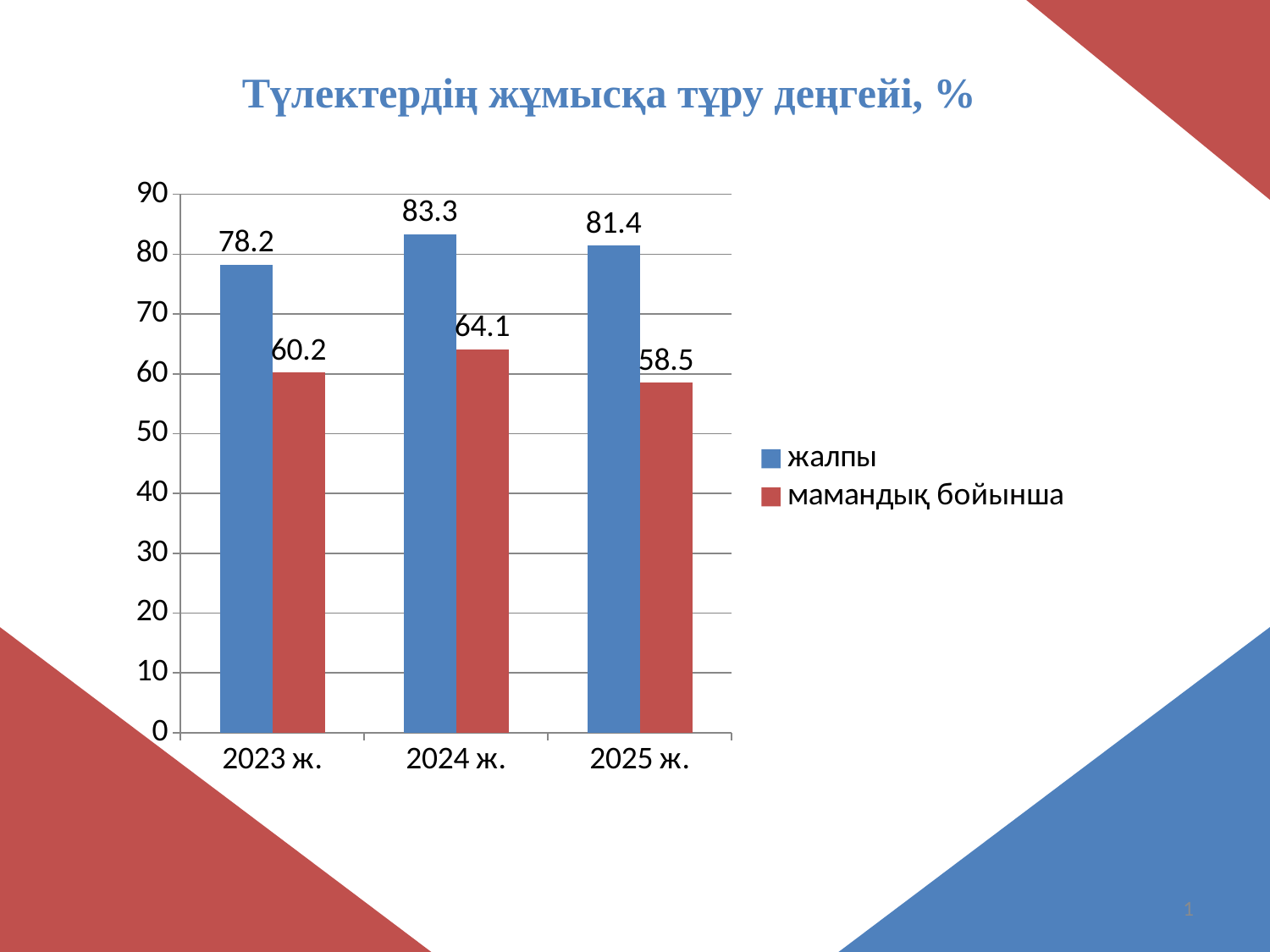
What is the difference between the жалпы and мамандық бойынша values in 2023 ж.? 18 How many series does the legend list? 2 What is the value for жалпы in 2024 ж.? 83.3 Is the жалпы value for 2025 ж. greater or less than 80? greater What is the value for мамандық бойынша in 2023 ж.? 60.2 What kind of chart is shown on the slide? bar chart In which year is the мамандық бойынша value lowest? 2025 ж. In which year is the жалпы value highest? 2024 ж. Which is larger: the мамандық бойынша value in 2024 ж. or in 2023 ж.? 2024 ж. What is the value for мамандық бойынша in 2025 ж.? 58.5 What is the difference between the жалпы values for 2024 ж. and 2025 ж.? 1.9 How many years are shown on the x axis? 3